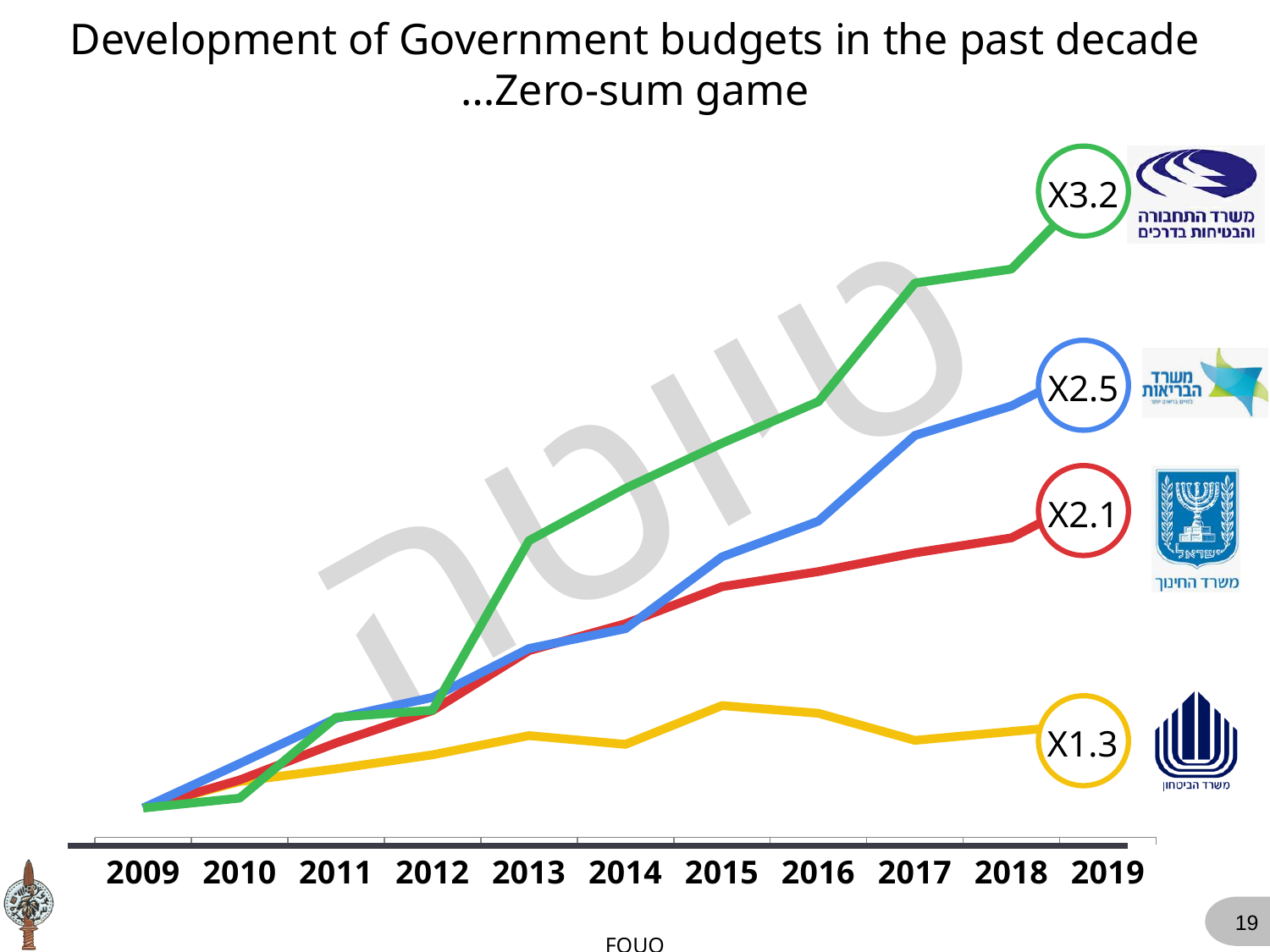
Which line ends with the highest multiplier? the green line (X3.2) What kind of chart is shown on the slide? line chart What is the difference between the end multipliers of the green line (X3.2) and the yellow line (X1.3)? 1.9 What multiplier label is shown at the end of the green line? X3.2 What multiplier label is shown at the end of the red line? X2.1 Does the green line generally rise or fall from 2009 to 2019? rise How many lines are plotted on the chart? 4 Which line ends with the lowest multiplier? the yellow line (X1.3) Which ends higher, the blue line or the red line? the blue line How many years are labelled along the x axis of the chart? 11 What multiplier label is shown at the end of the blue line? X2.5 What multiplier label is shown at the end of the yellow line? X1.3